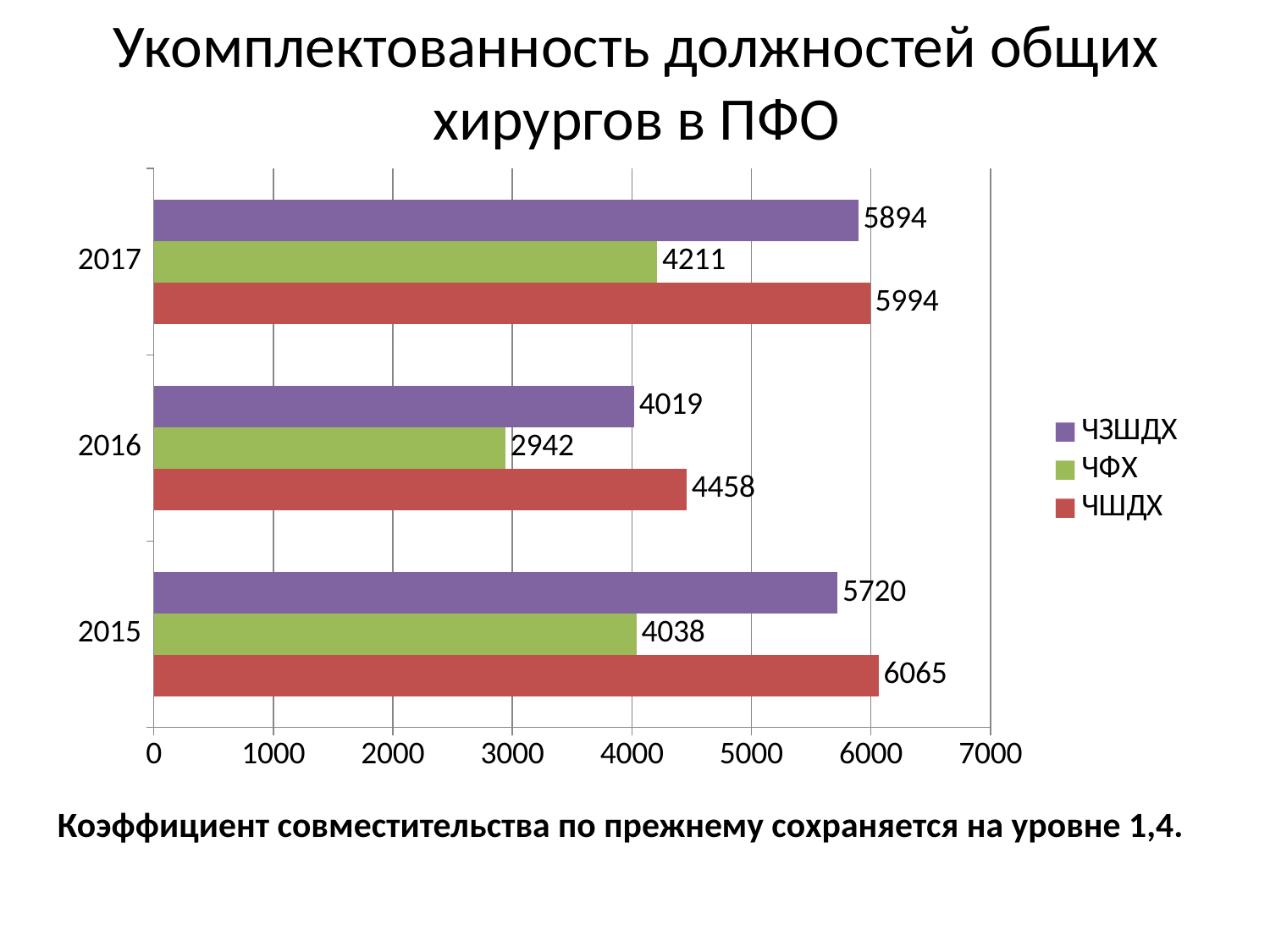
What is the title of the chart? Укомплектованность должностей общих хирургов в ПФО Which is larger in 2017: ЧЗШДХ or ЧФХ? ЧЗШДХ Which year has the lowest value for ЧФХ? 2016 What is the value of ЧФХ for 2016? 2942 What is the value of ЧЗШДХ for 2015? 5720 Which year has the highest value for ЧШДХ? 2015 How many series does the legend list? 3 What is the value of ЧШДХ for 2017? 5994 What is the difference between ЧШДХ and ЧЗШДХ in 2016? 439 How many years are shown on the chart? 3 Is the value of ЧФХ for 2015 greater or less than 5000? less What kind of chart is shown on the slide? bar chart